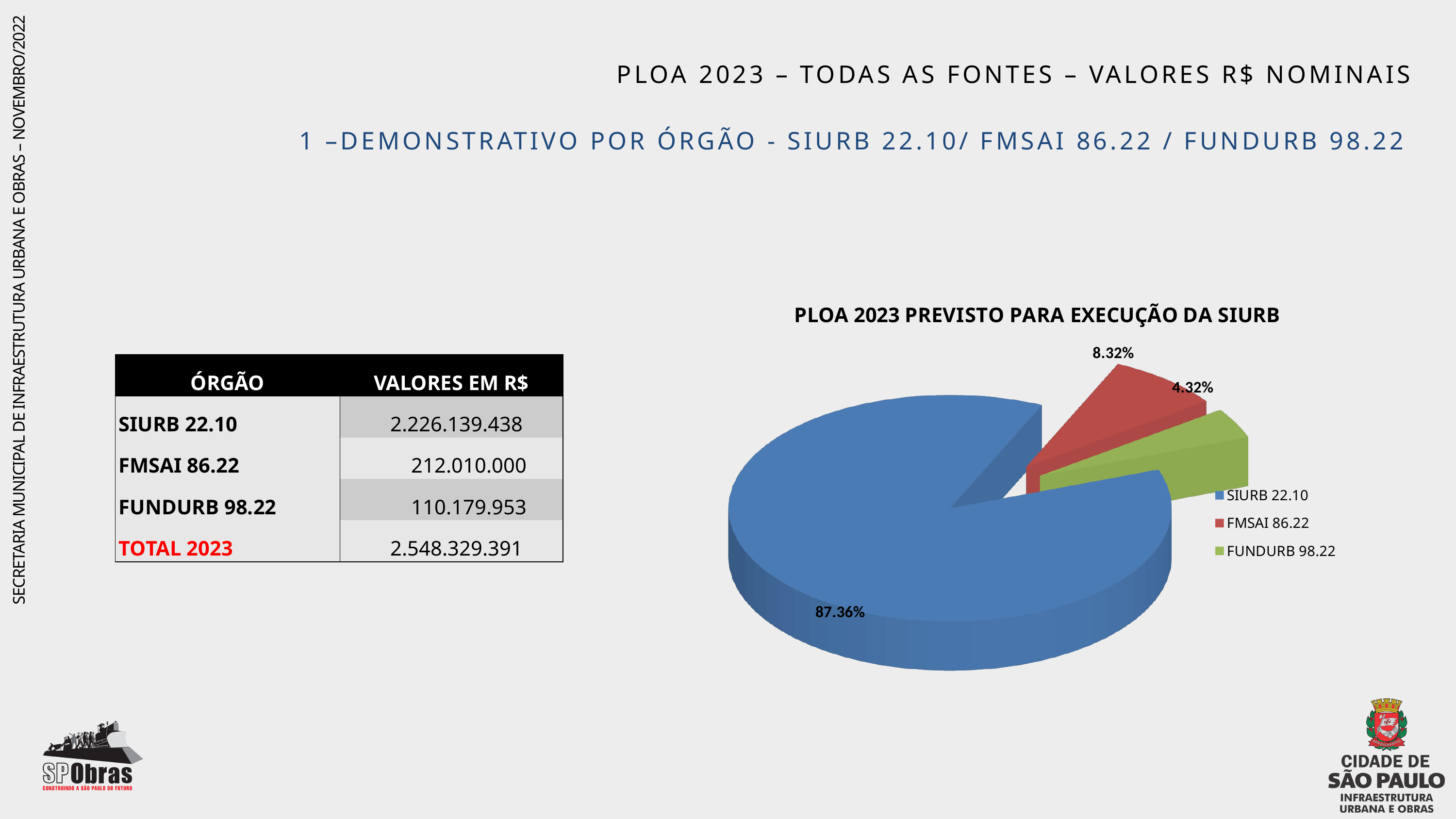
What share of the pie chart does FUNDURB 98.22 represent? 4.32% What colour is the SIURB 22.10 slice in the pie chart? Blue Which slice of the pie chart is the largest? SIURB 22.10 What kind of chart is shown on the slide? Pie chart How many slices does the pie chart have? 3 How many entries does the pie chart legend list? 3 What share of the pie chart does FMSAI 86.22 represent? 8.32% What share of the pie chart does SIURB 22.10 represent? 87.36% What is the difference in percentage points between the FMSAI 86.22 and FUNDURB 98.22 slices? 4.00% Which slice of the pie chart is the smallest? FUNDURB 98.22 Which is larger in the pie chart, FMSAI 86.22 or FUNDURB 98.22? FMSAI 86.22 What is the title of the pie chart? PLOA 2023 PREVISTO PARA EXECUÇÃO DA SIURB